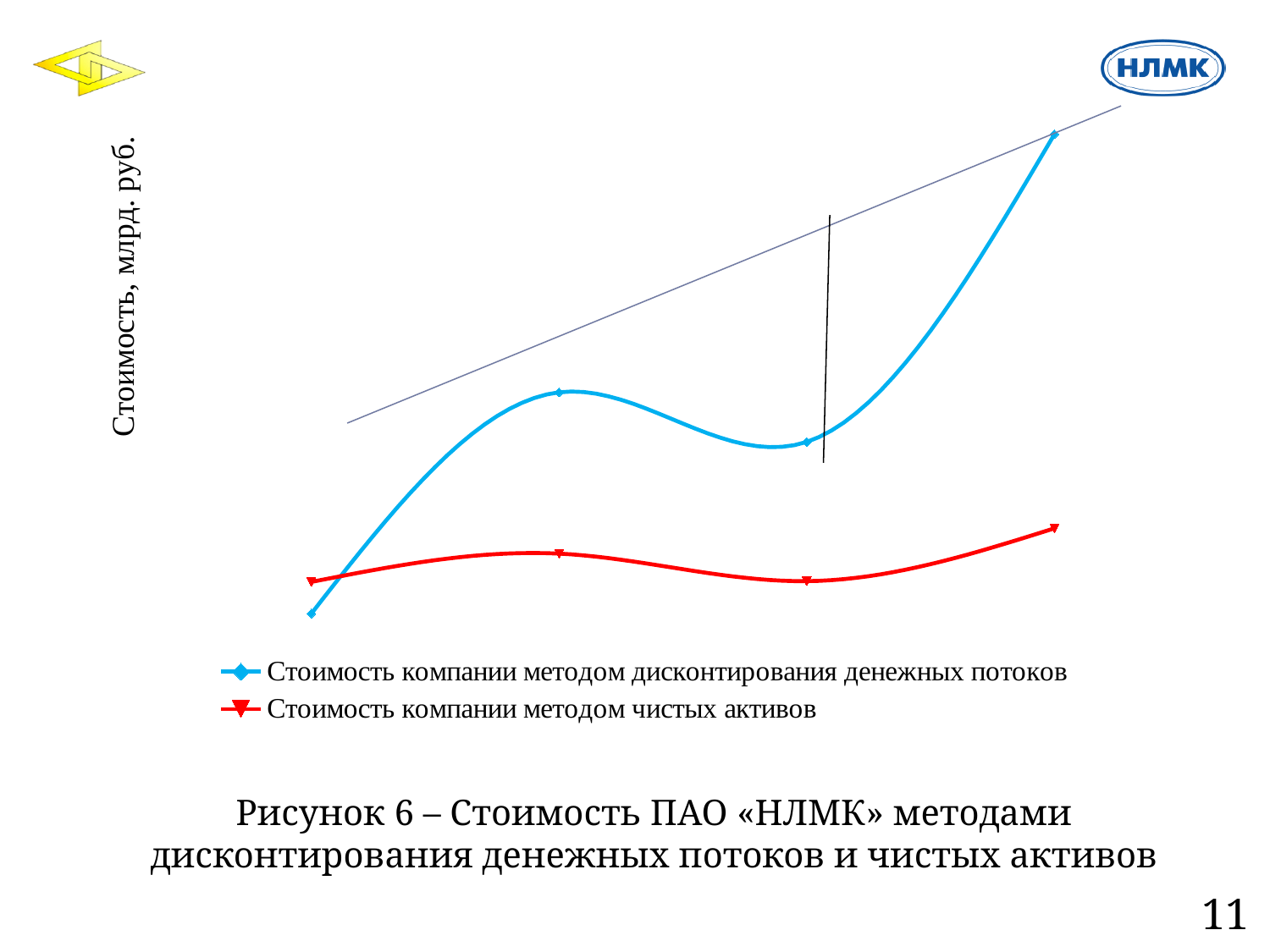
Which series is drawn in red? Стоимость компании методом чистых активов What kind of chart is shown on the slide? line chart Which point of the discounted cash flow series is the highest? the last (fourth) point How many data points does each line have? 4 Does the net assets series end higher or lower than it starts? higher At the last (rightmost) point, which series has the higher value: the discounted cash flow method or the net assets method? Стоимость компании методом дисконтирования денежных потоков Which point of the discounted cash flow series is the lowest? the first point Does the discounted cash flow series end higher or lower than it starts? higher What is the label of the vertical axis? Стоимость, млрд. руб. How many series does the legend list? 2 Which series reaches the highest value on the chart? Стоимость компании методом дисконтирования денежных потоков At the first (leftmost) point, which series has the higher value: the discounted cash flow method or the net assets method? Стоимость компании методом чистых активов